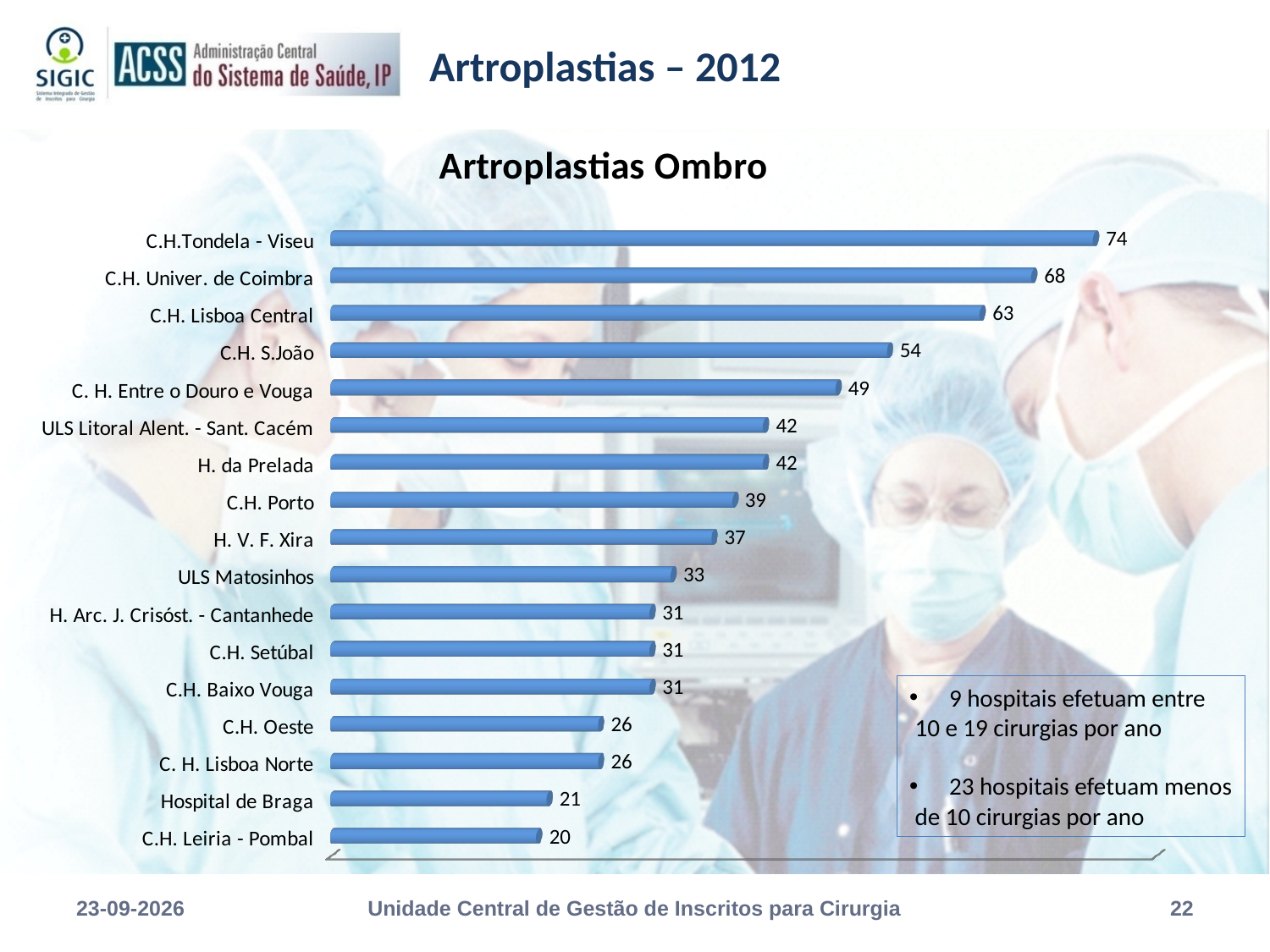
Which is larger, the value for C.H. Porto or the value for C.H. Setúbal? C.H. Porto What is the value for Hospital de Braga? 21 Which is larger, the value for C. H. Entre o Douro e Vouga or the value for H. da Prelada? C. H. Entre o Douro e Vouga What kind of chart is shown on the slide? Bar chart What is the value for C.H.Tondela - Viseu? 74 What is the difference between the values for C.H. Lisboa Central and ULS Matosinhos? 30 Which hospital has the highest value? C.H.Tondela - Viseu What is the value for H. V. F. Xira? 37 Which hospital has the lowest value? C.H. Leiria - Pombal How many hospitals are shown in the chart? 17 What is the difference between the values for C.H. Univer. de Coimbra and C.H. S.João? 14 What is the title of the chart? Artroplastias Ombro